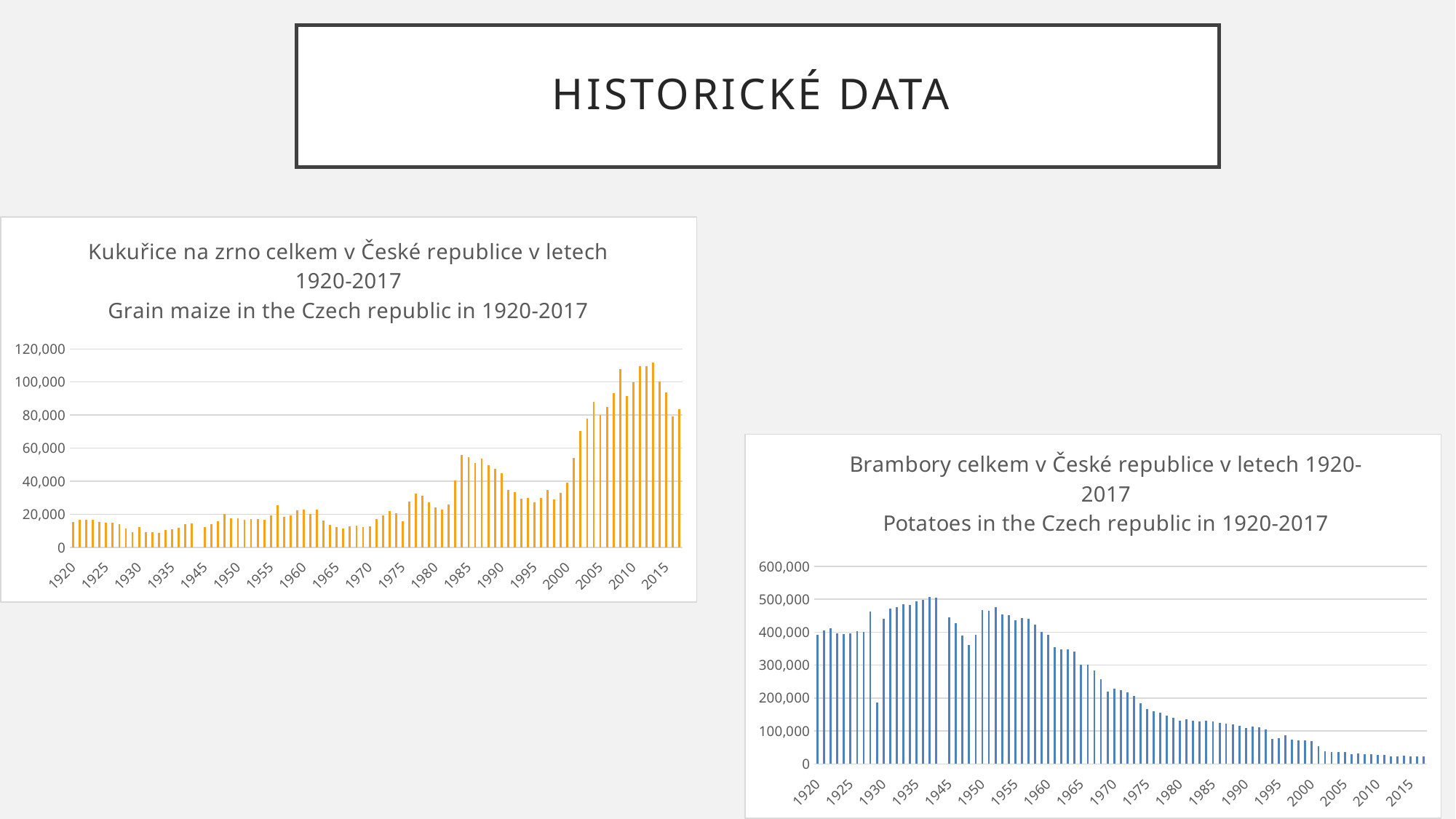
In the 'Grain maize in the Czech republic in 1920-2017' chart, is the value for 1920 greater or less than 20,000? less In the 'Potatoes in the Czech republic in 1920-2017' chart, do the values overall rise or fall from 1950 to 2017? fall What kind of chart is the 'Potatoes in the Czech republic in 1920-2017' chart? bar chart In the 'Grain maize in the Czech republic in 1920-2017' chart, is the value for 1985 greater or less than 40,000? greater What kind of chart is the 'Grain maize in the Czech republic in 1920-2017' chart? bar chart In the 'Grain maize in the Czech republic in 1920-2017' chart, is the value for 2005 greater or less than 60,000? greater In the 'Potatoes in the Czech republic in 1920-2017' chart, which is larger, the value for 1960 or the value for 2000? 1960 In the 'Grain maize in the Czech republic in 1920-2017' chart, do the values overall rise or fall from 1995 to 2014? rise What colour are the bars in the 'Grain maize in the Czech republic in 1920-2017' chart? orange